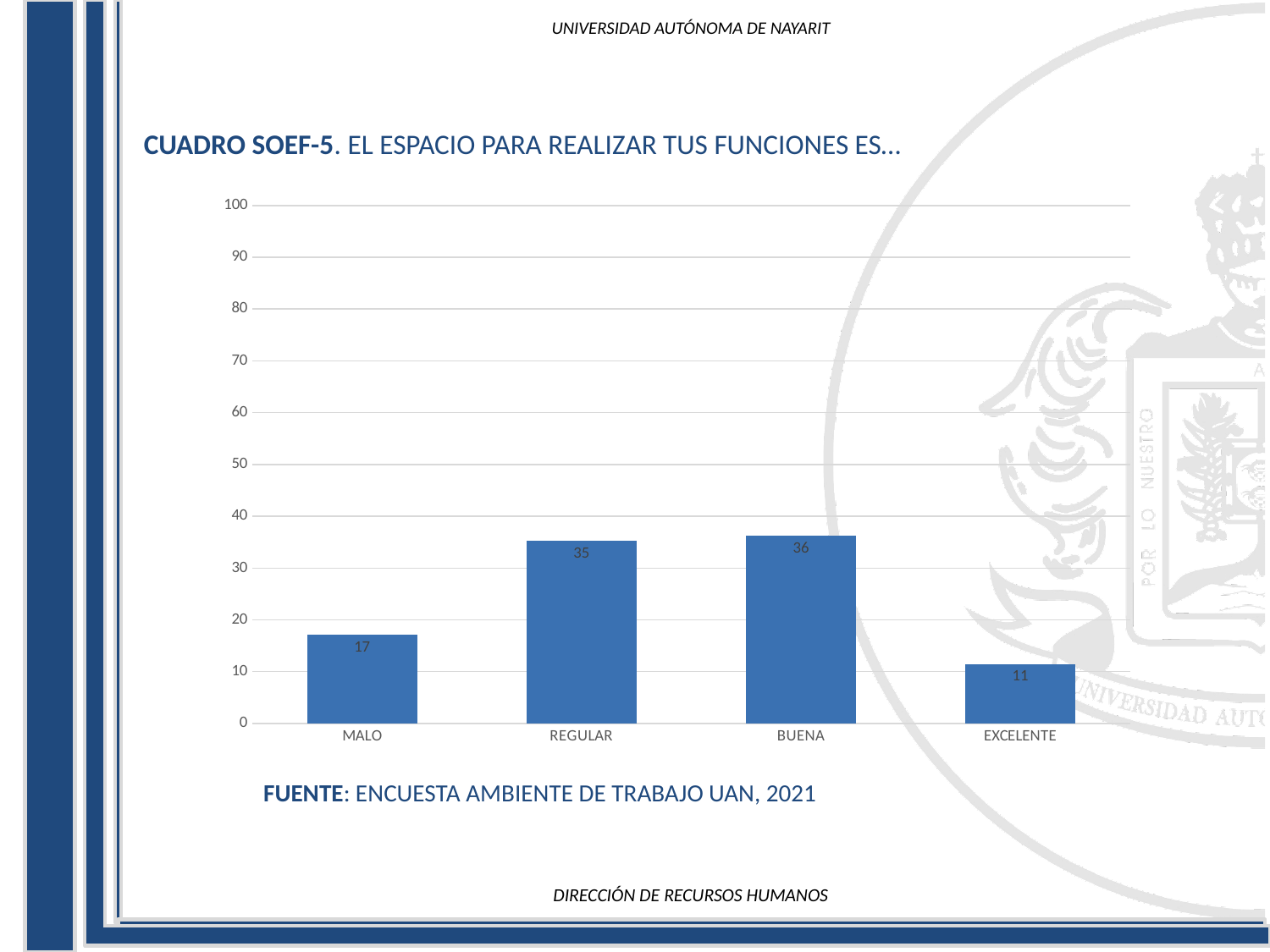
What is the source cited below the chart? ENCUESTA AMBIENTE DE TRABAJO UAN, 2021 Which is larger, the value for MALO or the value for EXCELENTE? MALO How many categories are shown on the x axis? 4 Which category has the lowest value? EXCELENTE What is the value for BUENA? 36 Is the value for BUENA greater or less than 40? less What is the difference between the values for REGULAR and MALO? 18 What is the value for MALO? 17 What is the value for EXCELENTE? 11 What is the difference between the values for BUENA and EXCELENTE? 25 What kind of chart is shown on the slide? bar chart What is the value for REGULAR? 35